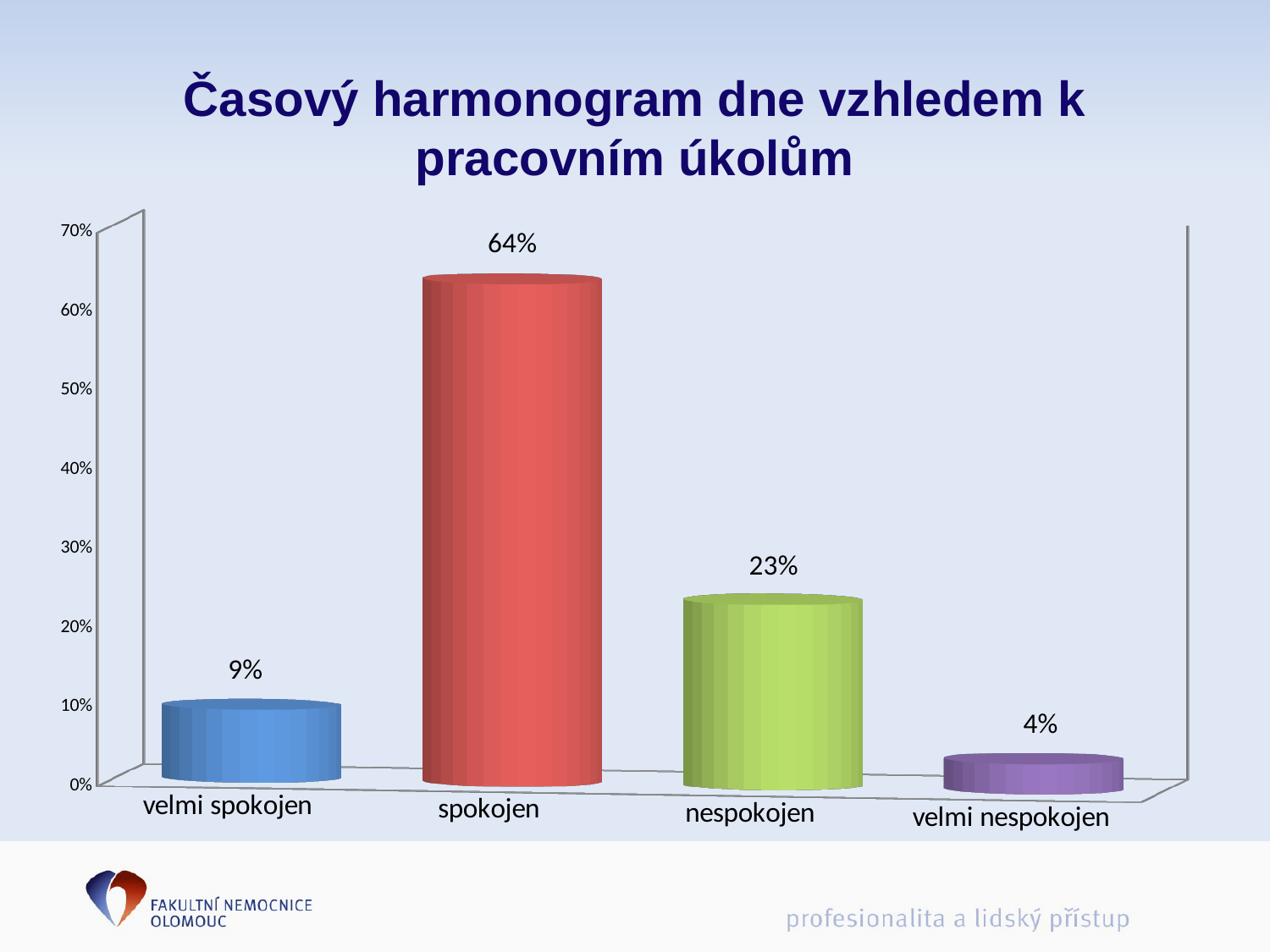
What kind of chart is shown on the slide? bar chart Which category has the lowest value? velmi nespokojen Which is larger, the value for "nespokojen" or the value for "velmi spokojen"? nespokojen Is the value for "spokojen" greater or less than 60%? greater What is the value for "velmi spokojen"? 9% What is the difference between the values for "spokojen" and "nespokojen"? 41% What is the value for "velmi nespokojen"? 4% How many categories are shown on the x axis? 4 What is the difference between the values for "velmi spokojen" and "velmi nespokojen"? 5% What is the value for "spokojen"? 64% Which category has the highest value? spokojen What is the value for "nespokojen"? 23%